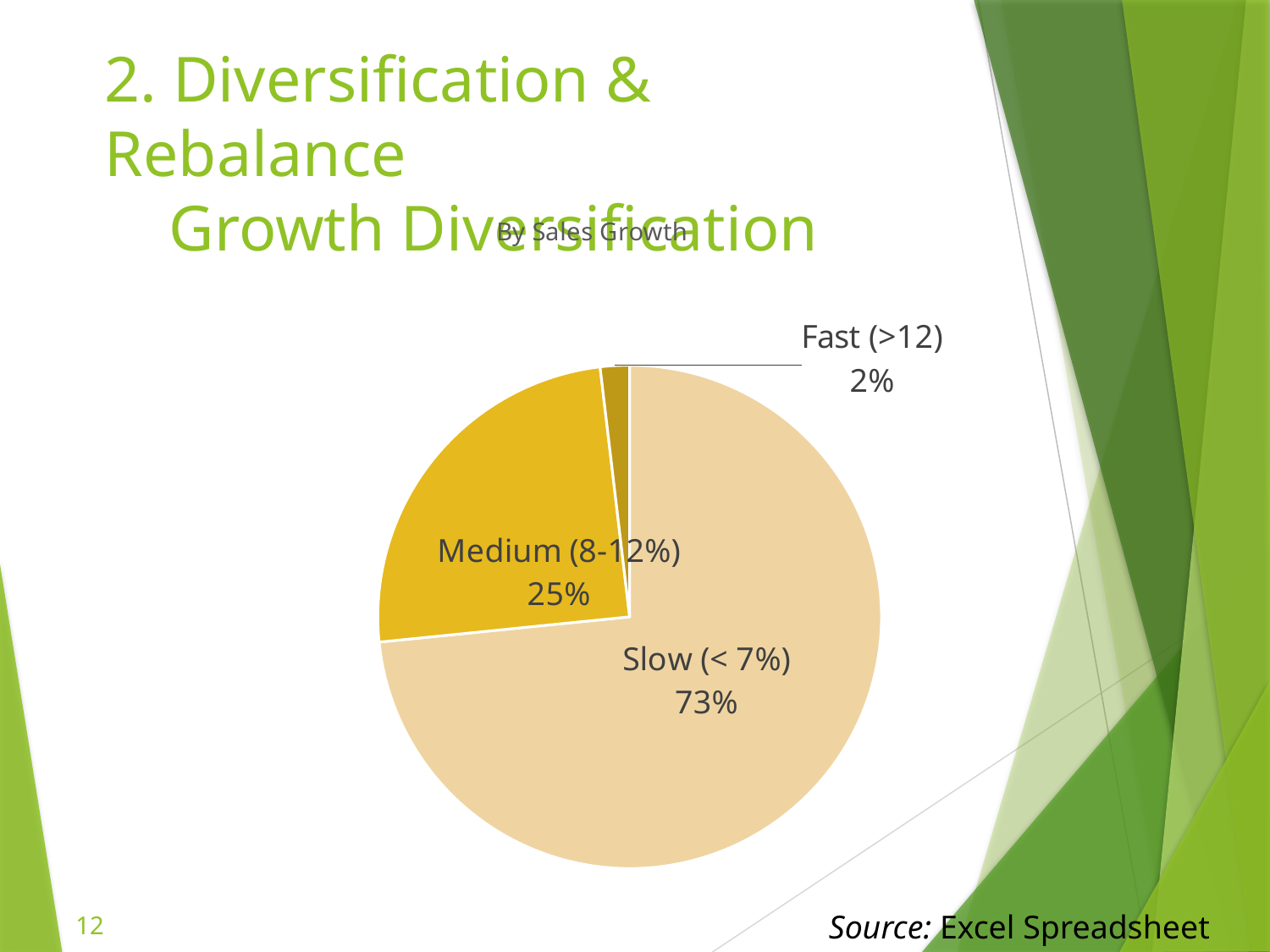
Which category has the largest slice of the pie? Slow (< 7%) Which category has the smallest slice of the pie? Fast (>12) What source is cited for the chart at the bottom of the slide? Excel Spreadsheet What is the difference in percentage points between the Medium (8-12%) and Fast (>12) slices? 23 What is the difference in percentage points between the Slow (< 7%) and Medium (8-12%) slices? 48 What share of the pie is Medium (8-12%)? 25% What share of the pie is Fast (>12)? 2% What is the chart's title? By Sales Growth What share of the pie is Slow (< 7%)? 73% How many slices does the pie chart have? 3 Which is larger, the Medium (8-12%) slice or the Fast (>12) slice? Medium (8-12%) What kind of chart is shown on the slide? pie chart